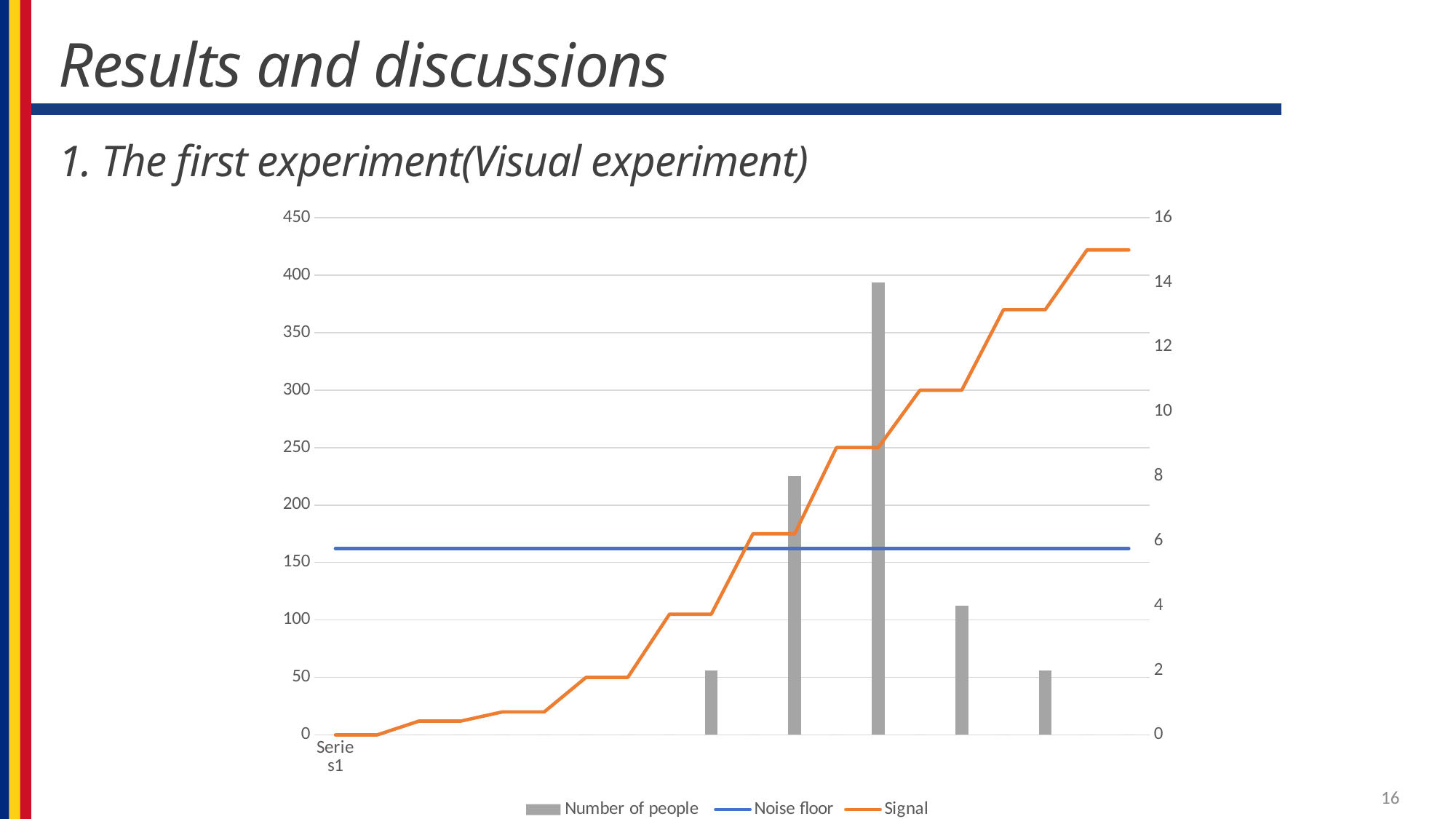
Is the Signal value higher at the left end or the right end of the chart? Right end Does the Signal line rise or fall from left to right? Rises What kind of chart is shown on the slide? A combination bar and line chart What are the three series named in the legend? Number of people, Noise floor, Signal Which series is drawn as gray bars? Number of people How many series does the legend list? 3 Is the tallest Number of people bar greater or less than 350 on the left axis? greater How many bars are plotted for Number of people? 5 Does the Noise floor line rise, fall, or stay flat across the chart? Stays flat Is the Signal line at its right-hand end greater or less than 14 on the right axis? greater What is the highest value shown on the left vertical axis? 450